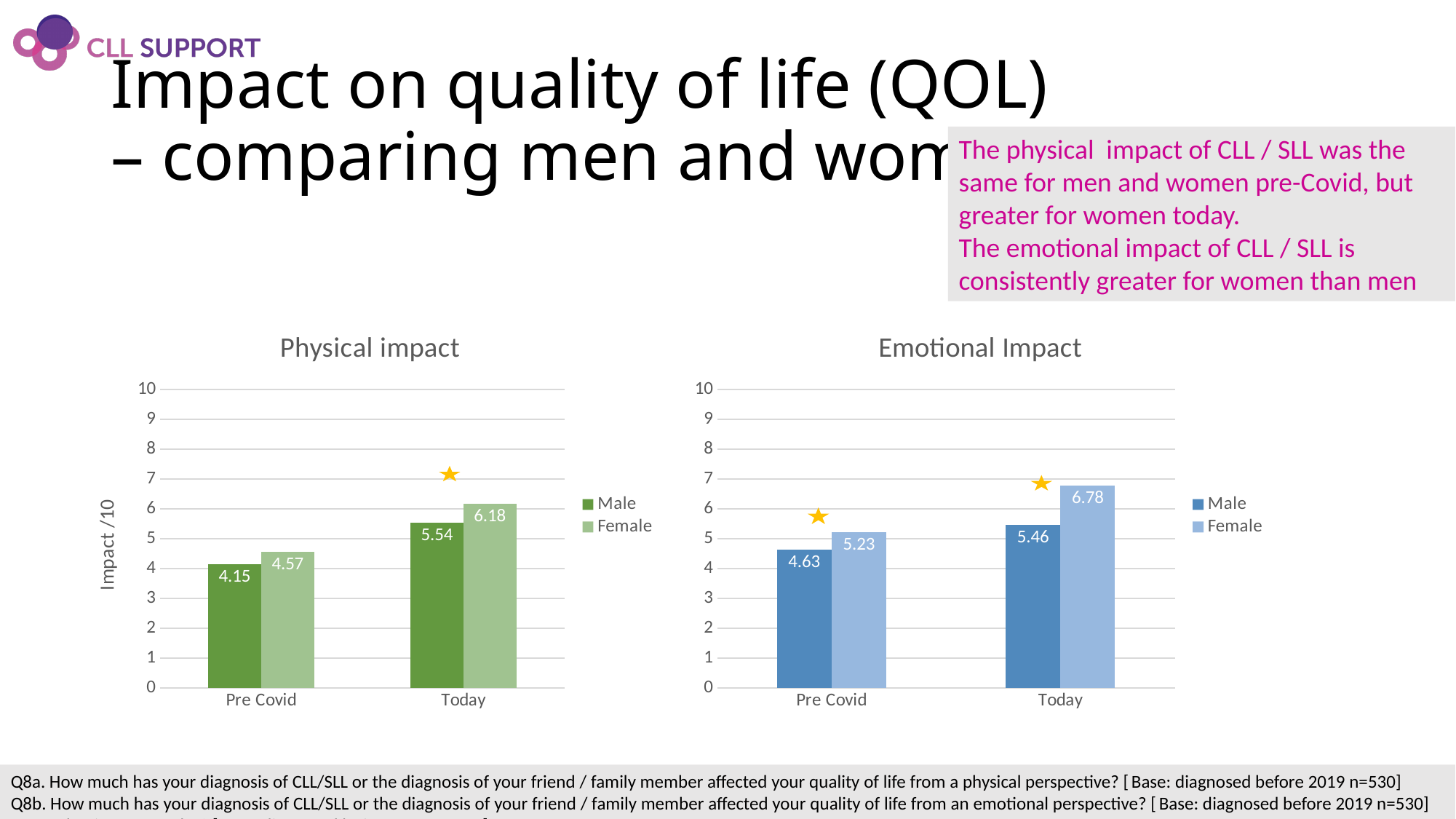
In the Emotional Impact chart, what is the difference between the Female and Male values for Pre Covid? 0.60 In the Physical impact chart, does the Male value rise or fall from Pre Covid to Today? Rise In the Physical impact chart, which bar has the lowest value? Male, Pre Covid In the Emotional Impact chart, which is larger for Today: Male or Female? Female In the Emotional Impact chart, which bar has the highest value? Female, Today In the Emotional Impact chart, what is the value for Female in the Pre Covid category? 5.23 How many series does the legend of the Physical impact chart list? 2 In the Physical impact chart, what is the value for Male in the Pre Covid category? 4.15 In the Emotional Impact chart, what is the value for Male in the Today category? 5.46 In the Physical impact chart, what is the value for Female in the Today category? 6.18 In the Physical impact chart, what is the difference between the Female and Male values for Today? 0.64 What kind of chart is the Emotional Impact chart? Bar chart